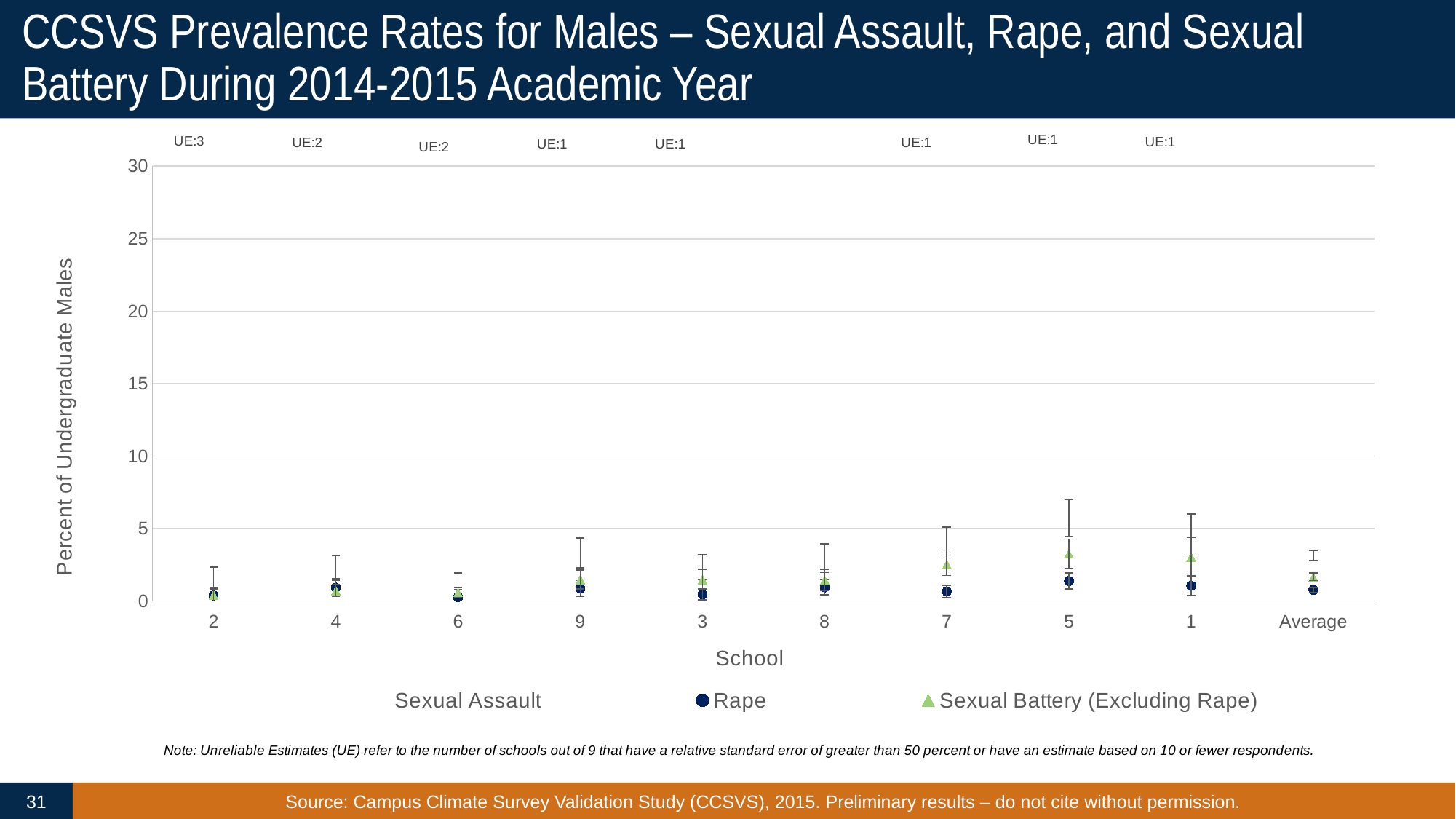
What is the title of the y axis? Percent of Undergraduate Males Is the Sexual Battery (Excluding Rape) value for school 7 greater or less than 10? less Is the Rape value for school 6 greater or less than 5? less What kind of chart is shown on the slide? Scatter (dot) chart with error bars Is the Average value for Sexual Battery (Excluding Rape) greater or less than 5? less Which is larger, the Sexual Battery (Excluding Rape) value for school 7 or for school 2? School 7 Which is larger, the Rape value for school 5 or for school 6? School 5 What is the title of the x axis? School How many series does the legend list? 3 How many categories are shown on the x axis? 10